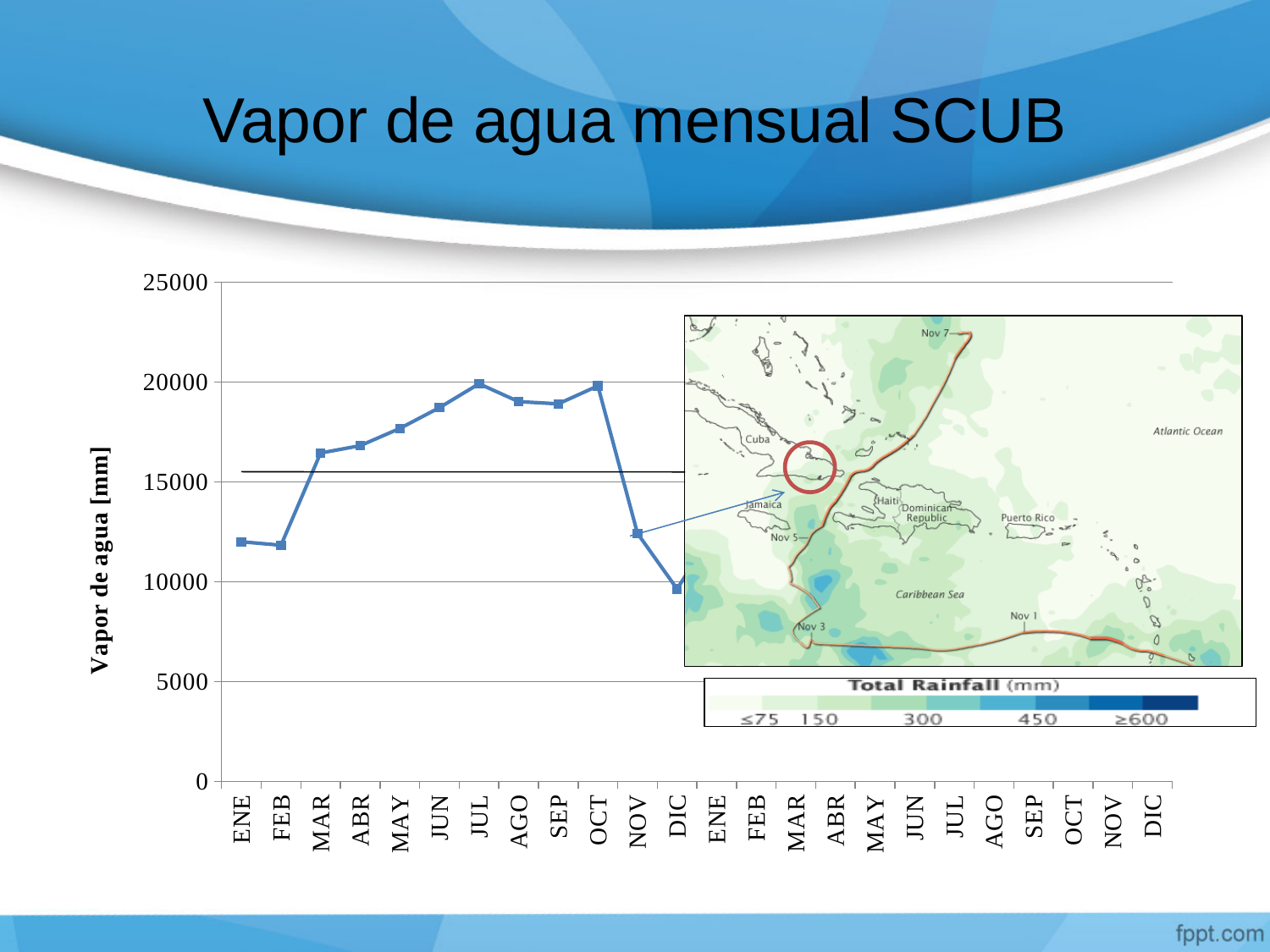
Is the value for the first JUN greater or less than 20000? less Which is larger, the value for the first OCT or the first NOV? OCT What is the label of the vertical axis? Vapor de agua [mm] Do the values rise or fall from the first OCT to the first DIC? fall How many month labels are shown along the x axis? 24 What kind of chart is shown on the slide? line chart Is the value for the first DIC greater or less than 15000? less Which is larger, the value for the first FEB or the first MAR? MAR Is the value for the first JUL greater or less than 15000? greater Do the values rise or fall from the first ENE to the first JUL? rise